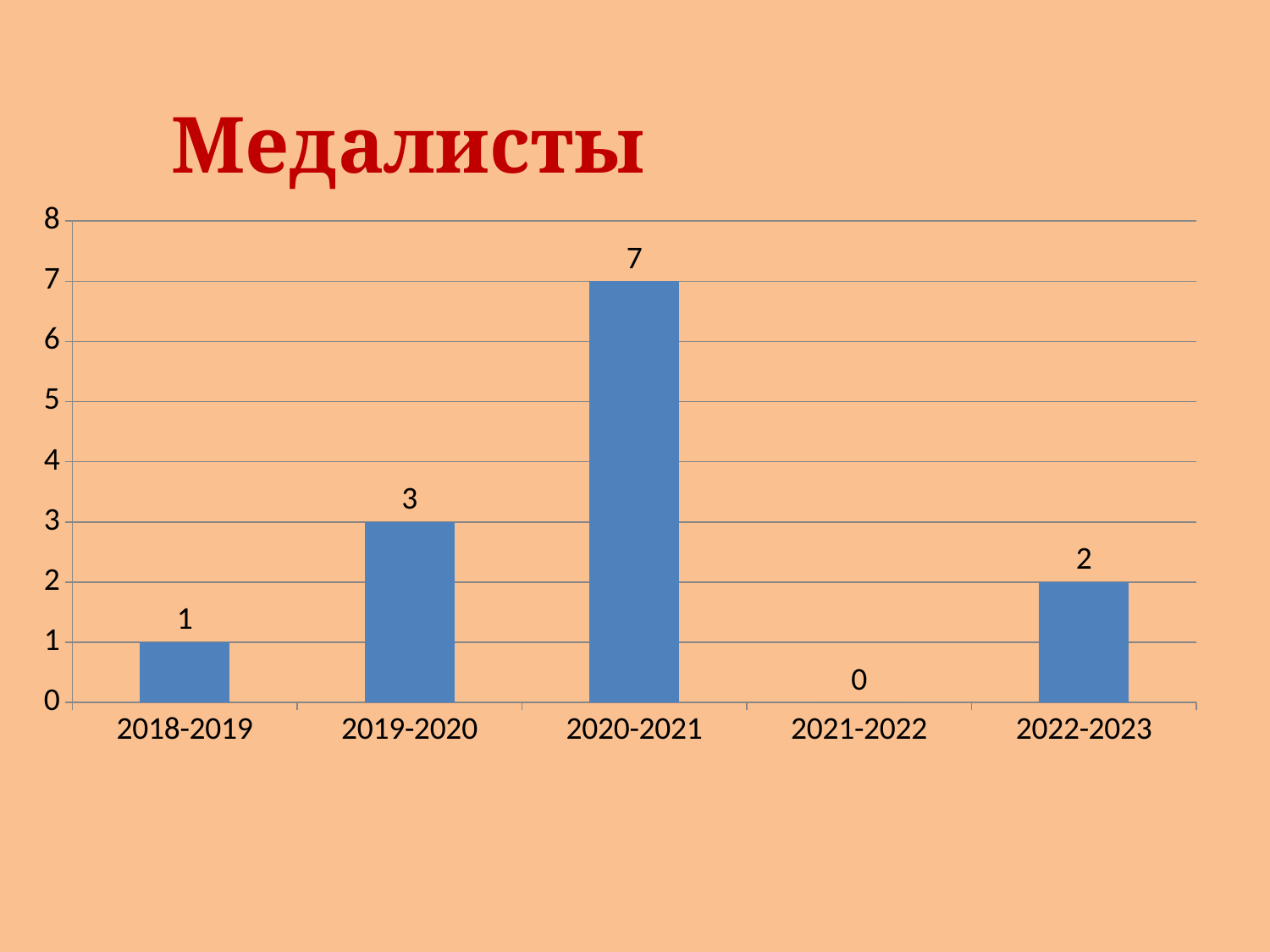
What is the value for 2022-2023? 2 How many categories are shown on the x axis? 5 What is the difference between the values for 2020-2021 and 2019-2020? 4 What is the value for 2018-2019? 1 Which is larger, the value for 2019-2020 or the value for 2022-2023? 2019-2020 Which category has the lowest value? 2021-2022 Which category has the highest value? 2020-2021 Do the values rise or fall from 2018-2019 to 2020-2021? Rise What is the value for 2020-2021? 7 What is the title of the slide? Медалисты What is the value for 2021-2022? 0 What kind of chart is shown on the slide? Bar chart